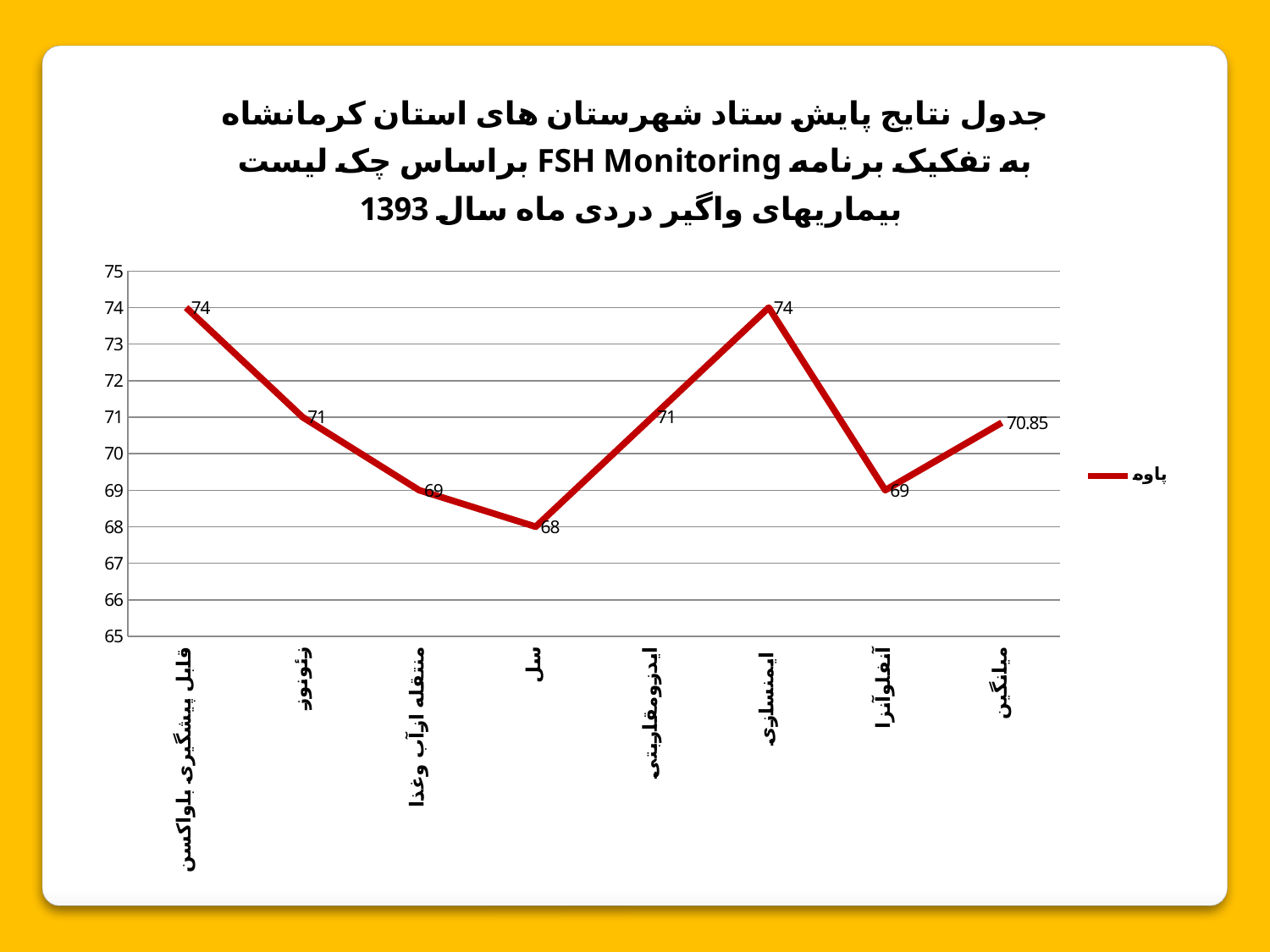
What is the value for آنفلوآنزا? 69 How many categories are plotted along the x axis? 8 Which category has the lowest value? سل How many series does the legend list? 1 What is the value for میانگین? 70.85 What kind of chart is shown on the slide? line chart Which is larger, the value for ایدز و مقاربتی or the value for منتقله از آب و غذا? ایدز و مقاربتی What is the value for زئونوز? 71 What is the name of the series shown in the legend? پاوه What is the difference between the values for ایمنسازی and سل? 6 What is the value for سل? 68 What is the highest value plotted on the chart? 74